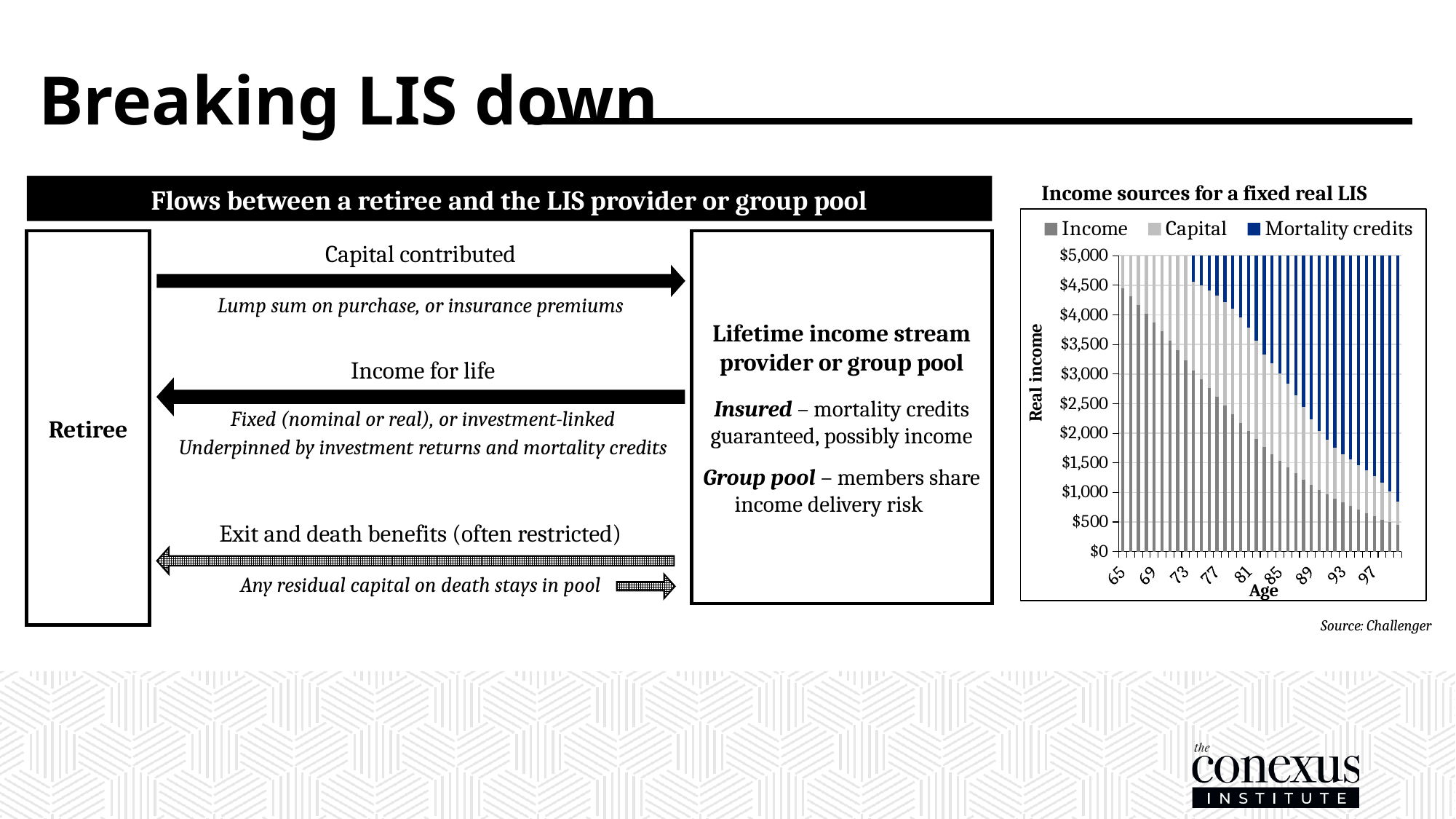
How many age labels are shown on the x axis of the "Income sources for a fixed real LIS" chart? 9 In the "Income sources for a fixed real LIS" chart, does the Income series rise or fall as age increases? Fall In the "Income sources for a fixed real LIS" chart, is the Income value at age 65 greater or less than $4,000? greater In the "Income sources for a fixed real LIS" chart, does the Mortality credits series rise or fall as age increases? Rise What kind of chart is "Income sources for a fixed real LIS"? Bar chart (stacked) In the "Income sources for a fixed real LIS" chart, is the Income value at age 97 greater or less than $1,000? less What are the three series named in the legend of the "Income sources for a fixed real LIS" chart? Income, Capital, Mortality credits In the "Income sources for a fixed real LIS" chart, which series is larger at age 97: Mortality credits or Income? Mortality credits How many series does the legend of the "Income sources for a fixed real LIS" chart list? 3 What is the label on the vertical axis of the "Income sources for a fixed real LIS" chart? Real income In the "Income sources for a fixed real LIS" chart, which series is larger at age 65: Income or Capital? Income